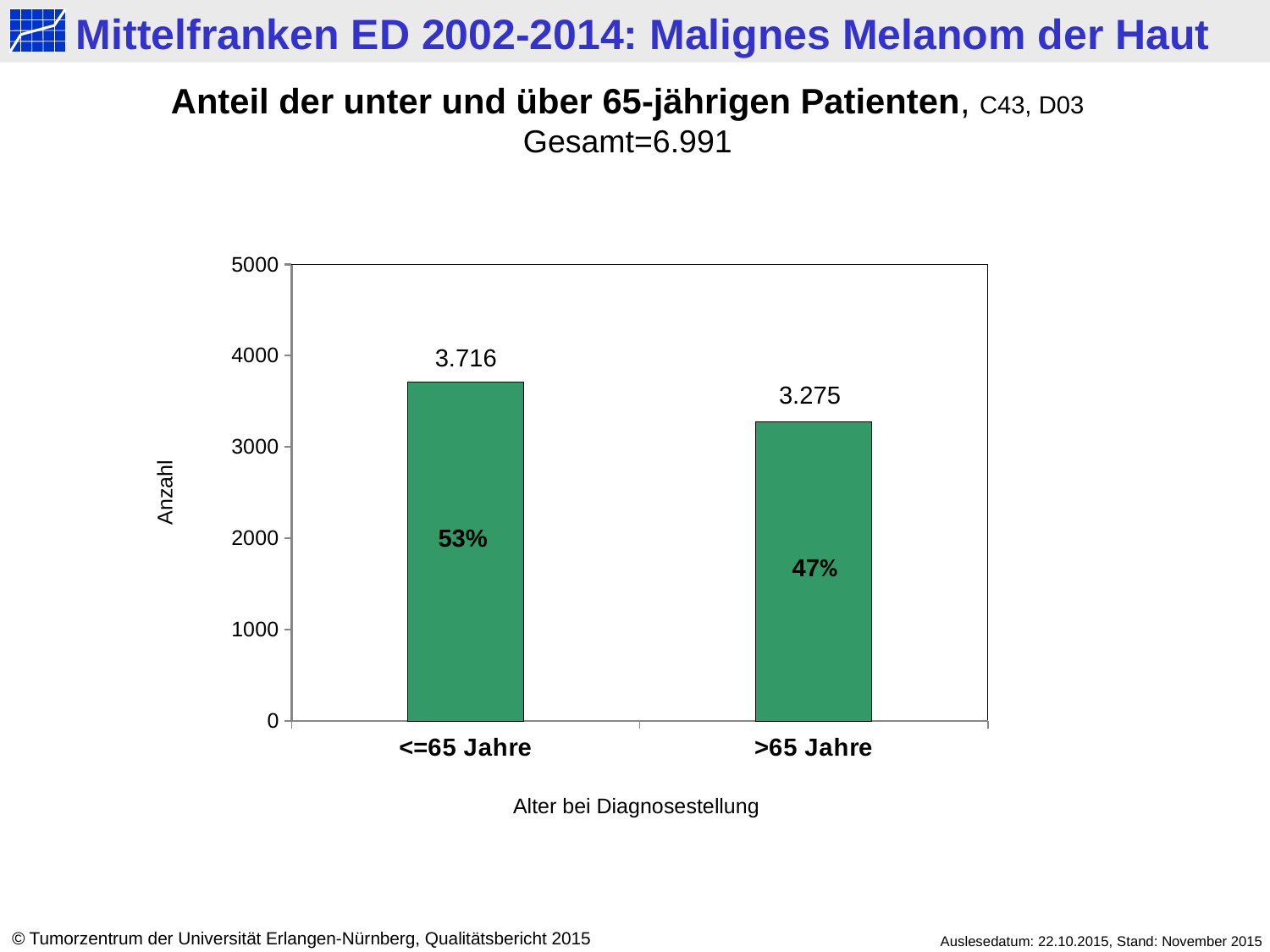
What is the difference between the values for <=65 Jahre and >65 Jahre? 441 Which category has the lowest value? >65 Jahre Which is larger, the value for <=65 Jahre or for >65 Jahre? <=65 Jahre What percentage is shown on the >65 Jahre bar? 47% What is the label of the x axis? Alter bei Diagnosestellung How many categories are shown on the x axis? 2 Which category has the highest value? <=65 Jahre What is the value for the >65 Jahre category? 3.275 What percentage is shown on the <=65 Jahre bar? 53% Is the value for >65 Jahre greater or less than 4000? less What is the value for the <=65 Jahre category? 3.716 What kind of chart is shown on the slide? bar chart